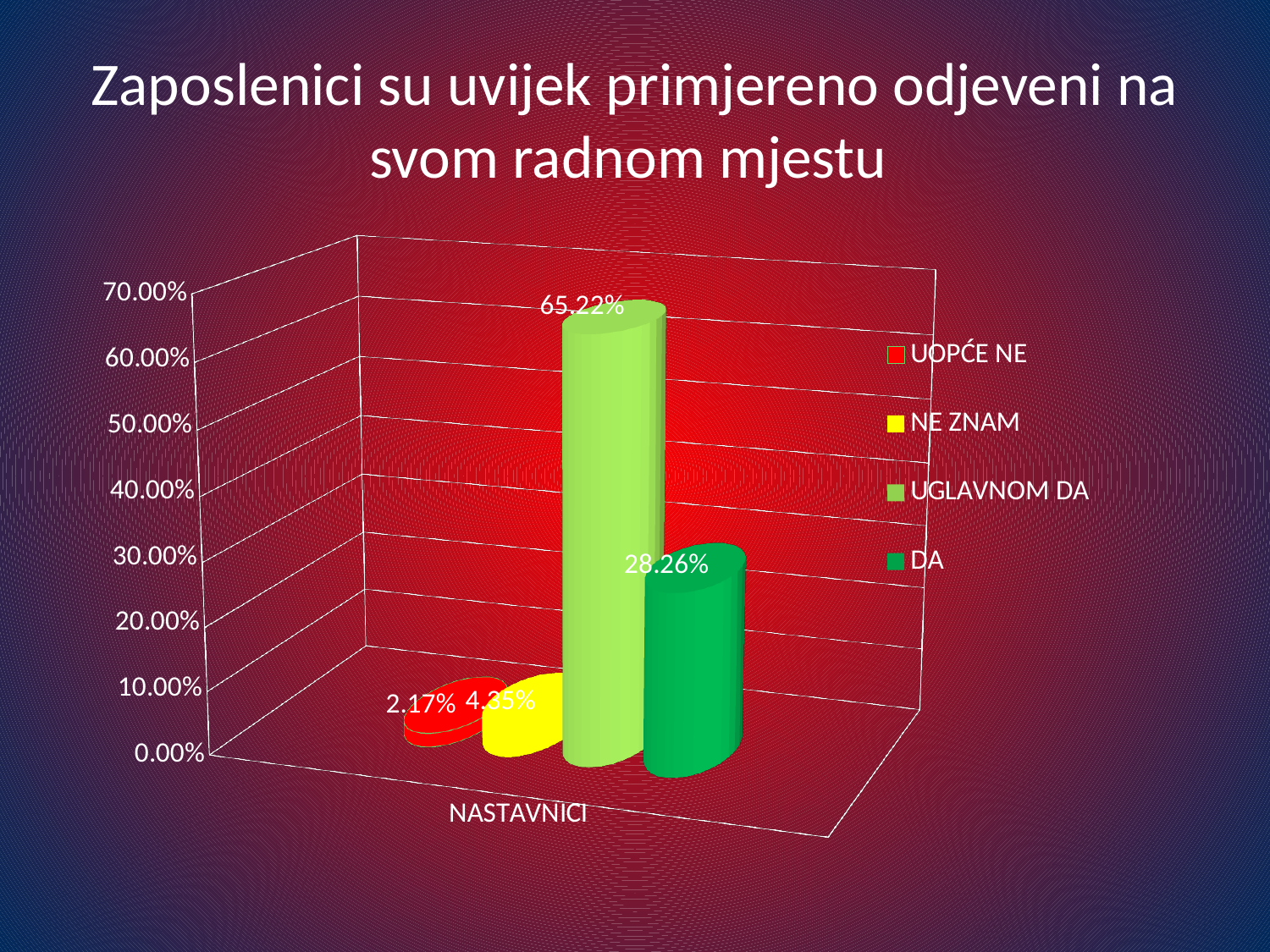
What is the difference between the values for UGLAVNOM DA and DA? 36.96% Which series has the lowest value? UOPĆE NE What is the value for UOPĆE NE? 2.17% What is the value for DA? 28.26% What kind of chart is shown on the slide? bar chart How many series does the legend list? 4 What is the value for NE ZNAM? 4.35% What is the category label shown on the x axis? NASTAVNICI What is the value for UGLAVNOM DA? 65.22% Is the value for DA greater or less than 30.00%? less Which series has the highest value? UGLAVNOM DA Which is larger, the value for DA or the value for NE ZNAM? DA